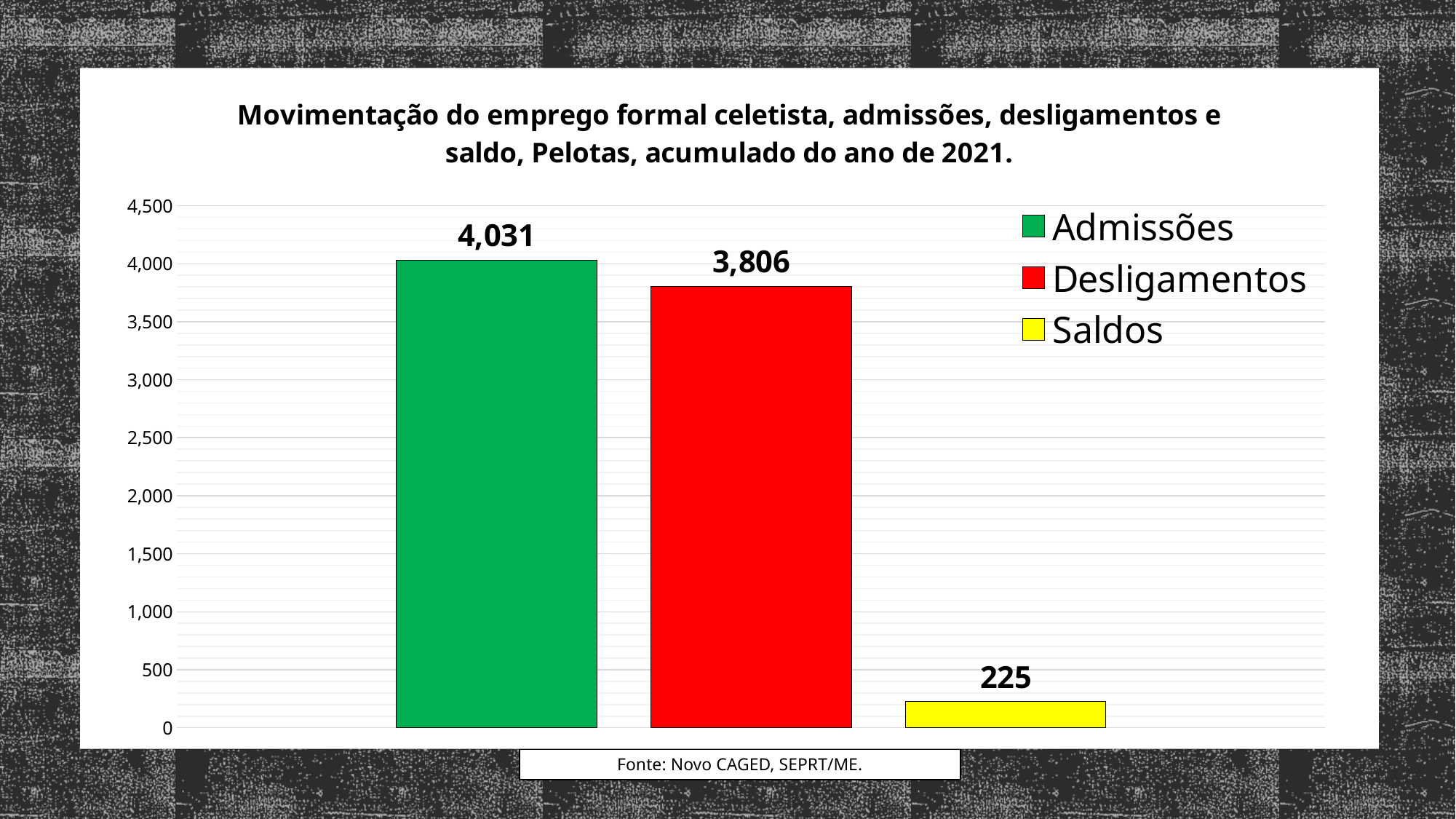
How many bars are plotted on the chart? 3 What is the value for Admissões? 4,031 What is the difference between Admissões and Desligamentos? 225 Which series has the highest value? Admissões Which is larger, Admissões or Desligamentos? Admissões Is the value for Desligamentos greater or less than 4,000? less Which series has the lowest value? Saldos What is the value for Saldos? 225 How many series does the legend list? 3 What colour is the bar for Saldos? yellow What is the value for Desligamentos? 3,806 What kind of chart is shown on the slide? bar chart